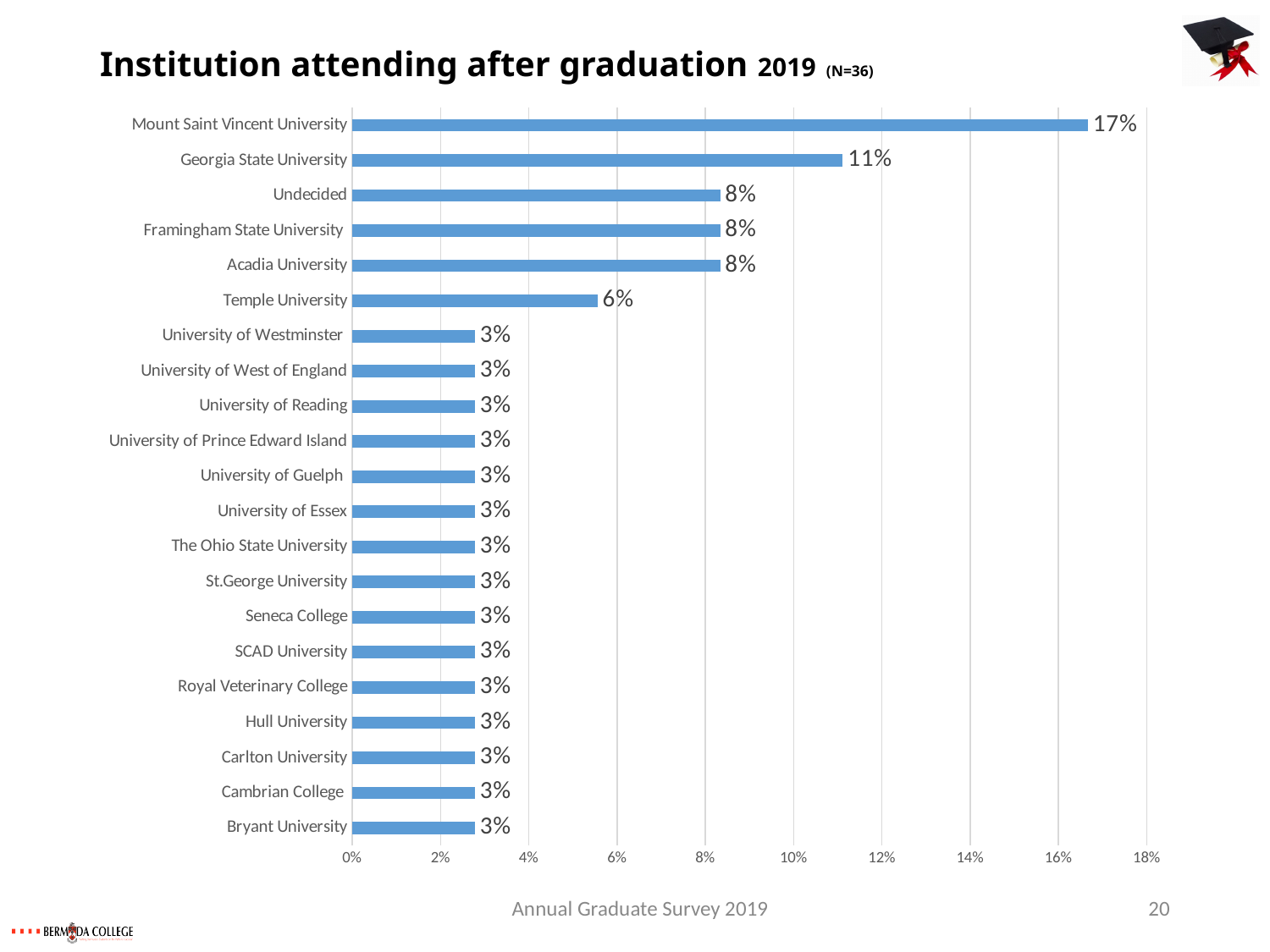
Is the value for Georgia State University greater or less than 10%? greater Which has a higher value, Temple University or Acadia University? Acadia University What is the value shown for Temple University? 6% What is the difference in percentage points between Mount Saint Vincent University and Georgia State University? 6% What percentage is shown for Seneca College? 3% What percentage of graduates are attending Mount Saint Vincent University? 17% How many institutions (categories) are listed in the chart? 21 What type of chart is shown on the slide? Bar chart Which institution has the highest percentage of graduates attending? Mount Saint Vincent University What is the value shown for Georgia State University? 11% What is the sample size (N) stated in the chart title? 36 What percentage of graduates are Undecided about the institution they will attend? 8%